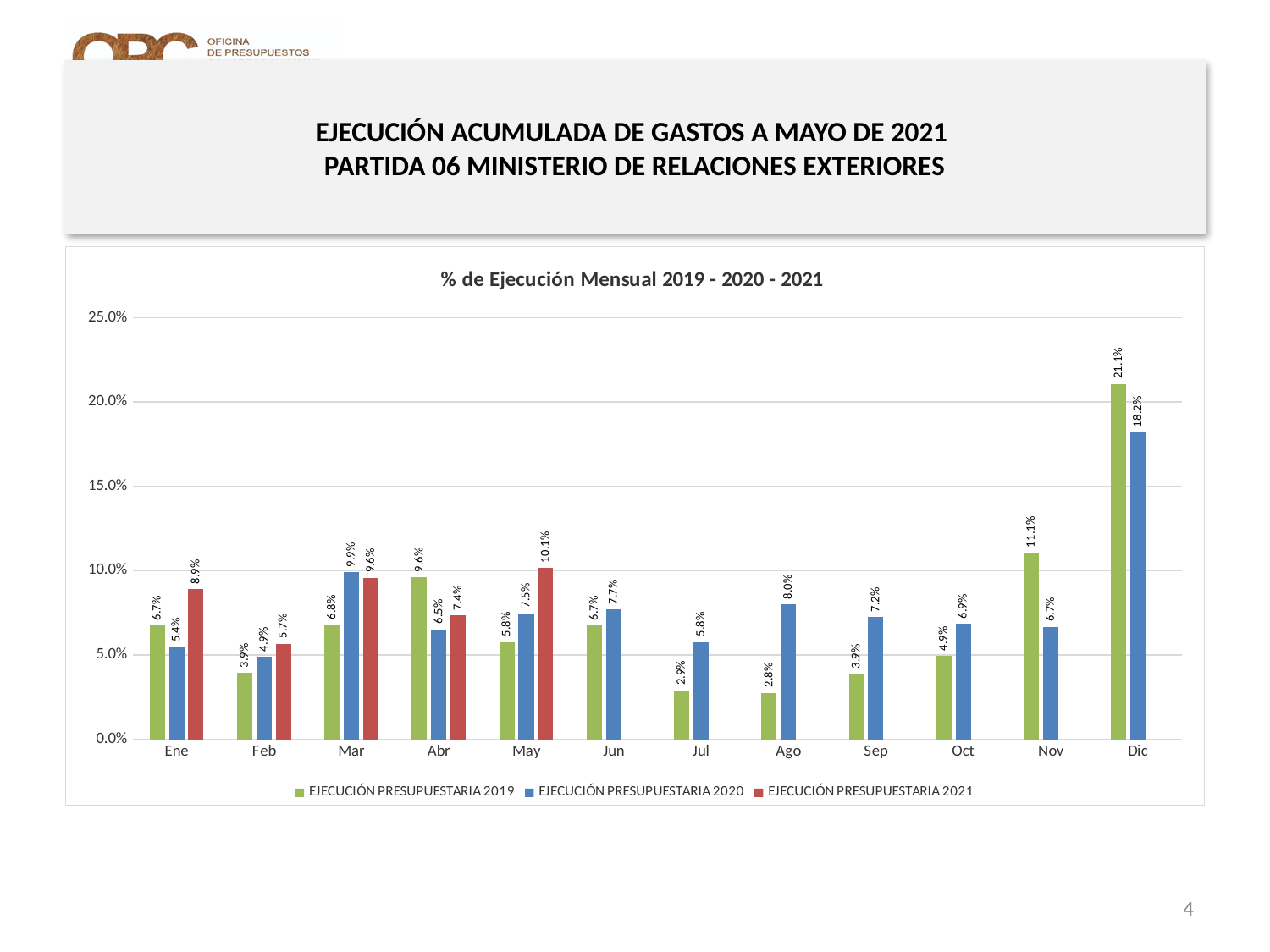
Which is larger in Abr: EJECUCIÓN PRESUPUESTARIA 2019 or EJECUCIÓN PRESUPUESTARIA 2021? EJECUCIÓN PRESUPUESTARIA 2019 What is the difference between the EJECUCIÓN PRESUPUESTARIA 2019 and EJECUCIÓN PRESUPUESTARIA 2020 values in Dic? 2.9% What kind of chart is shown? bar chart What is the value for EJECUCIÓN PRESUPUESTARIA 2019 in Dic? 21.1% What is the value for EJECUCIÓN PRESUPUESTARIA 2021 in May? 10.1% How many months are shown on the x axis? 12 In which month is the EJECUCIÓN PRESUPUESTARIA 2019 value lowest? Ago In which month is the EJECUCIÓN PRESUPUESTARIA 2020 value highest? Dic What is the value for EJECUCIÓN PRESUPUESTARIA 2020 in Ago? 8.0% What is the title of the chart? % de Ejecución Mensual 2019 - 2020 - 2021 How many series does the legend list? 3 Is the value for EJECUCIÓN PRESUPUESTARIA 2019 in Nov greater or less than 10.0%? greater